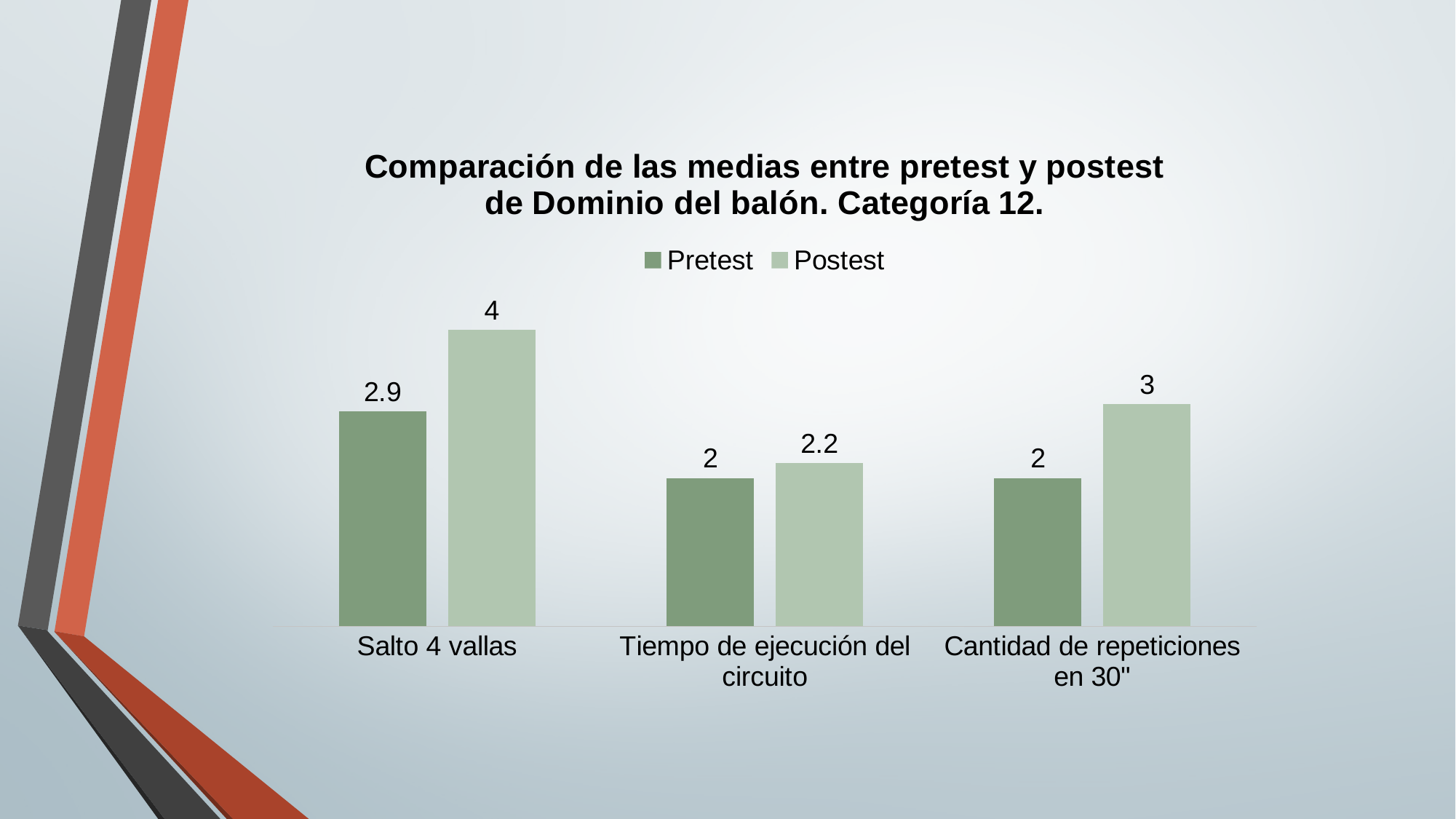
How many categories are shown on the x axis? 3 Which category has the highest Postest value? Salto 4 vallas Which category has the lowest Postest value? Tiempo de ejecución del circuito What is the Postest value for Salto 4 vallas? 4 What kind of chart is shown on the slide? Bar chart What is the difference between the Postest and Pretest values for Cantidad de repeticiones en 30''? 1 What is the difference between the Postest and Pretest values for Salto 4 vallas? 1.1 What is the Pretest value for Cantidad de repeticiones en 30''? 2 What is the Pretest value for Salto 4 vallas? 2.9 Which is larger for Tiempo de ejecución del circuito, the Pretest or the Postest value? Postest What is the Postest value for Tiempo de ejecución del circuito? 2.2 How many series does the legend list? 2